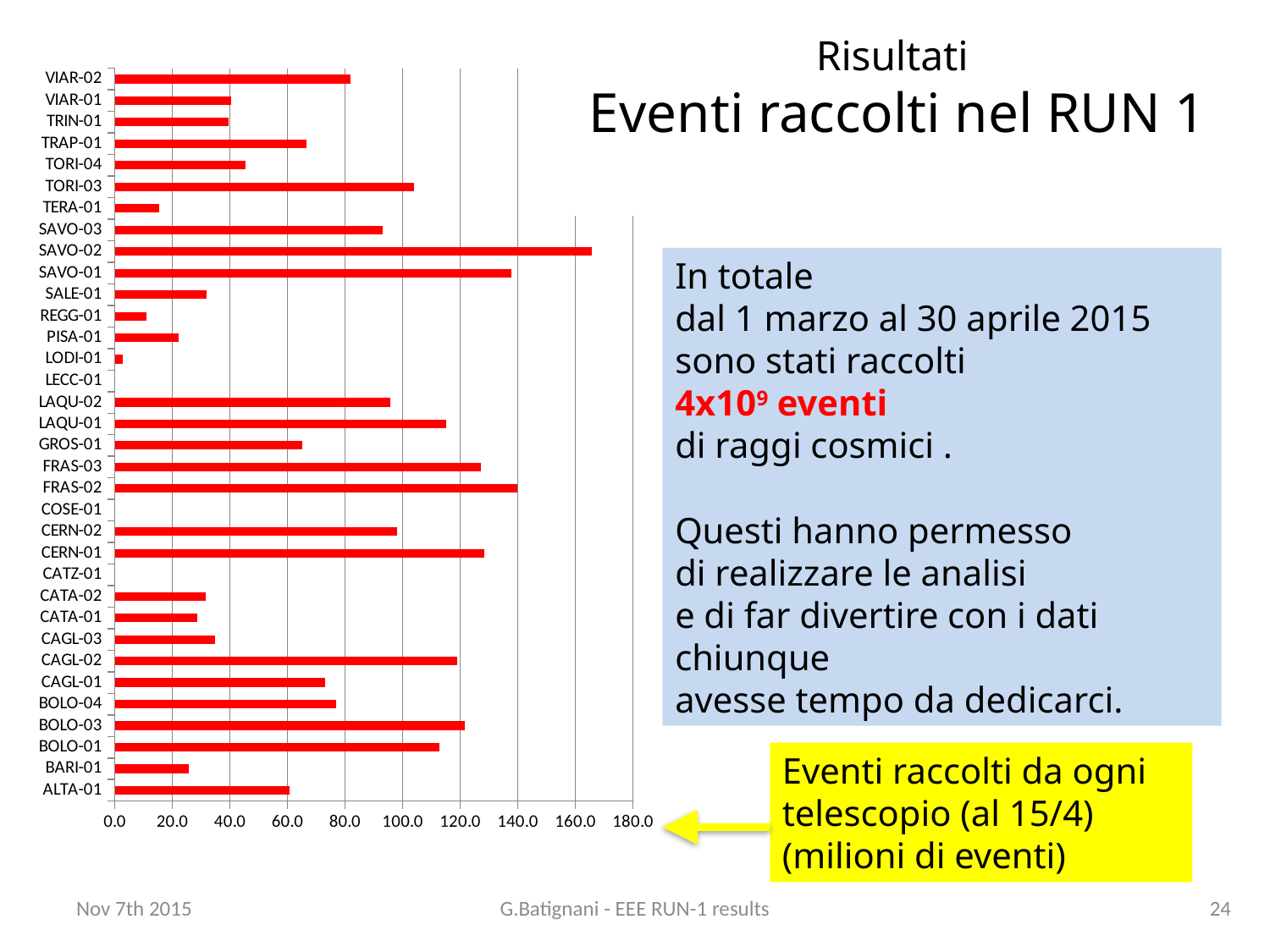
Which has a larger value, SAVO-02 or SAVO-01? SAVO-02 How many telescope categories are listed on the vertical axis of the chart? 34 Is the value for TORI-03 greater or less than 100? greater Which has a larger value, CERN-01 or CERN-02? CERN-01 Is the value for SAVO-02 greater or less than 160? greater Is the value for TERA-01 greater or less than 20? less Which telescope has the highest value in the chart? SAVO-02 Which has a larger value, VIAR-02 or VIAR-01? VIAR-02 What kind of chart is shown on the slide? bar chart What is the maximum value shown on the horizontal axis of the chart? 180.0